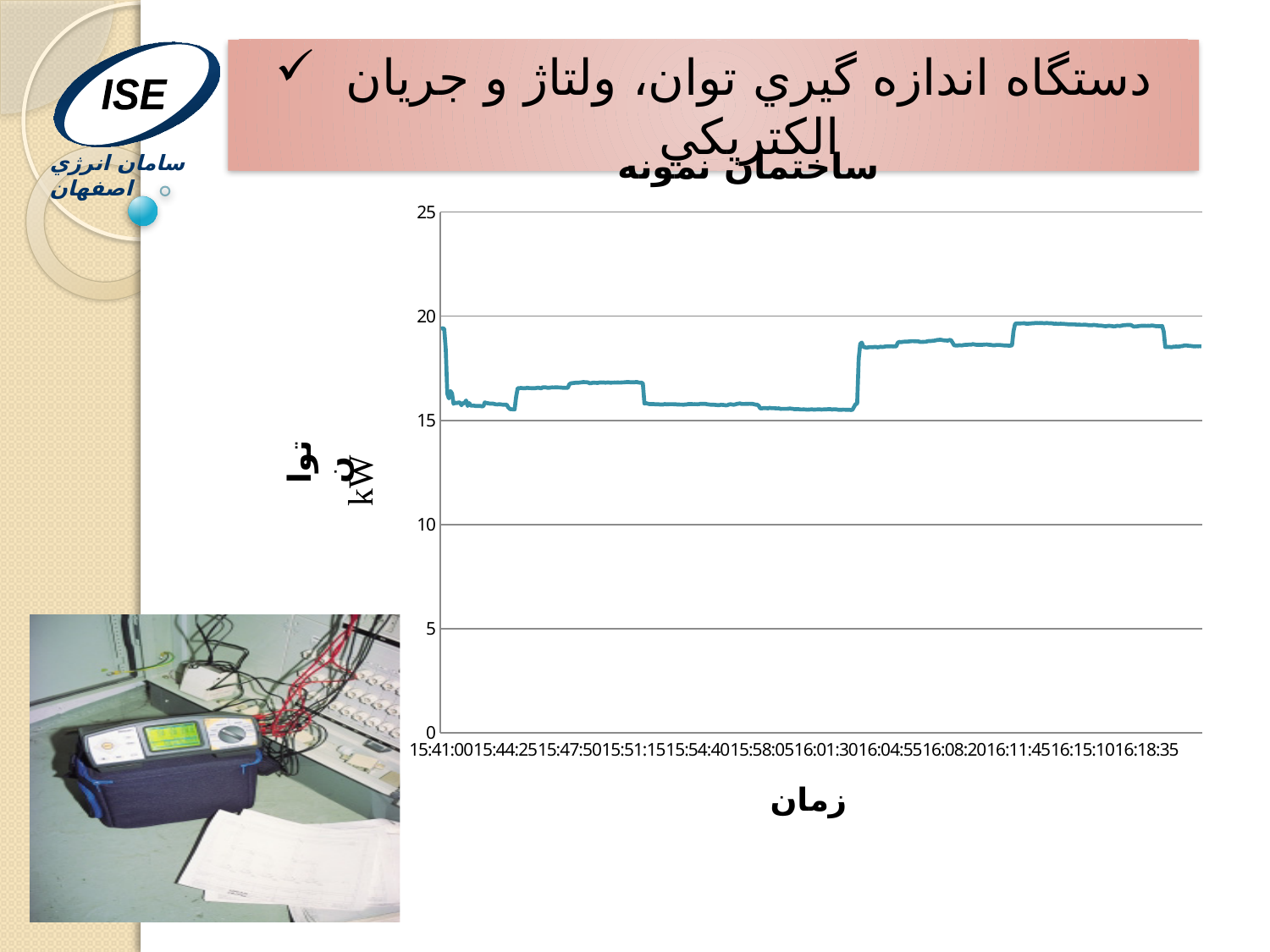
Is the value at 16:11:45 greater or less than 20? less Does the line rise or fall between 15:54:40 and 16:11:45? rise What is the label of the x axis of the chart? زمان Is the value at 15:47:50 greater or less than 10? greater How many time labels are shown on the x axis? 12 Which is larger, the value at 15:54:40 or the value at 16:11:45? 16:11:45 What kind of chart is shown on the slide? line chart What is the title of the chart? ساختمان نمونه Is the value at 16:11:45 greater or less than 15? greater Which is larger, the value at 15:47:50 or the value at 16:04:55? 16:04:55